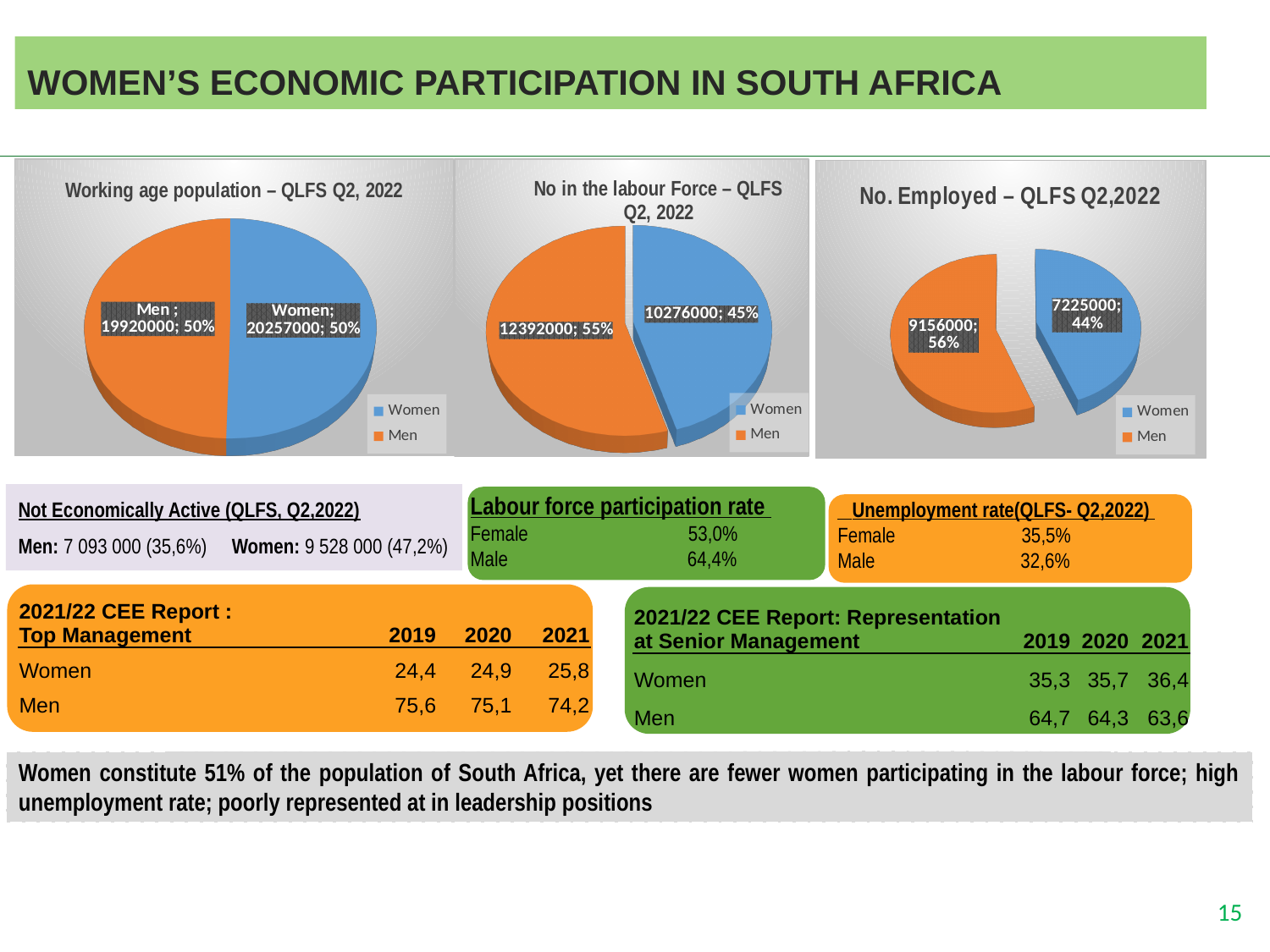
In the 'No in the labour Force – QLFS Q2, 2022' chart, what is the difference between the Men and Women values? 2116000 In the 'No. Employed – QLFS Q2,2022' chart, what is the difference between the Men and Women values? 1931000 How many entries does the legend of the 'No. Employed – QLFS Q2,2022' chart list? 2 In the 'No in the labour Force – QLFS Q2, 2022' chart, what share of the pie do Women represent? 45% In the 'Working age population – QLFS Q2, 2022' chart, what is the value for Women? 20257000 How many slices does the 'Working age population – QLFS Q2, 2022' pie chart have? 2 What kind of chart is the 'No. Employed – QLFS Q2,2022' chart? Pie chart In the 'No. Employed – QLFS Q2,2022' chart, what is the value for Women? 7225000 In the 'No in the labour Force – QLFS Q2, 2022' chart, which is larger, Women or Men? Men In the 'Working age population – QLFS Q2, 2022' chart, what is the value for Men? 19920000 In the 'No in the labour Force – QLFS Q2, 2022' chart, what is the value for Men? 12392000 In the 'No. Employed – QLFS Q2,2022' chart, what share of the pie do Men represent? 56%